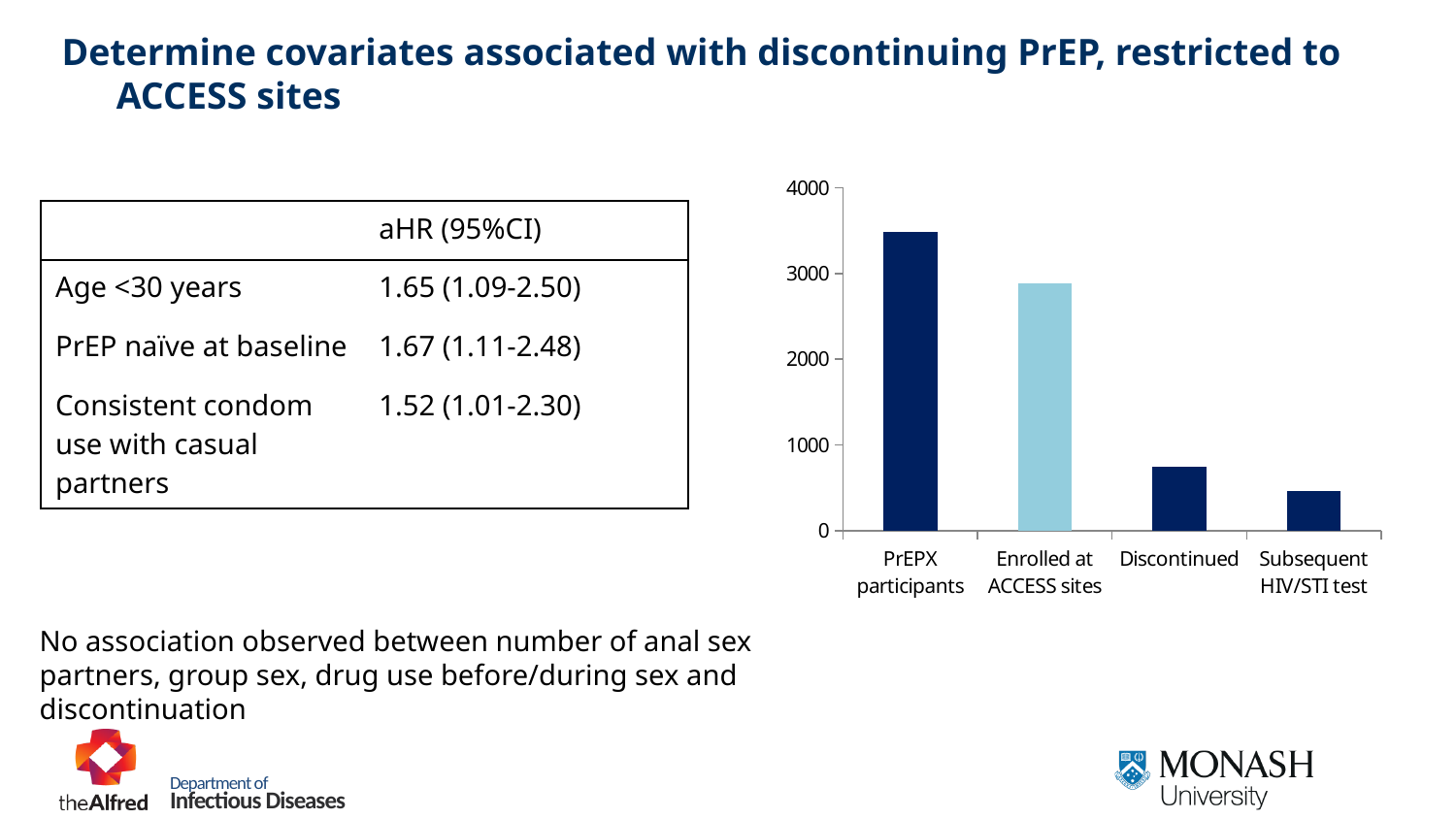
Is the value for PrEPX participants greater or less than 3000? greater Which category has the lowest value in the bar chart? Subsequent HIV/STI test Which bar in the chart is coloured light blue rather than dark blue? Enrolled at ACCESS sites Is the value for Discontinued greater or less than 1000? less Which is larger, the value for Discontinued or the value for Subsequent HIV/STI test? Discontinued Which is larger, the value for Enrolled at ACCESS sites or the value for Discontinued? Enrolled at ACCESS sites Do the bar values rise or fall from left to right along the x axis? fall Is the value for Subsequent HIV/STI test greater or less than 1000? less Which category has the highest value in the bar chart? PrEPX participants What kind of chart is shown on the slide? bar chart How many categories are shown on the x axis of the bar chart? 4